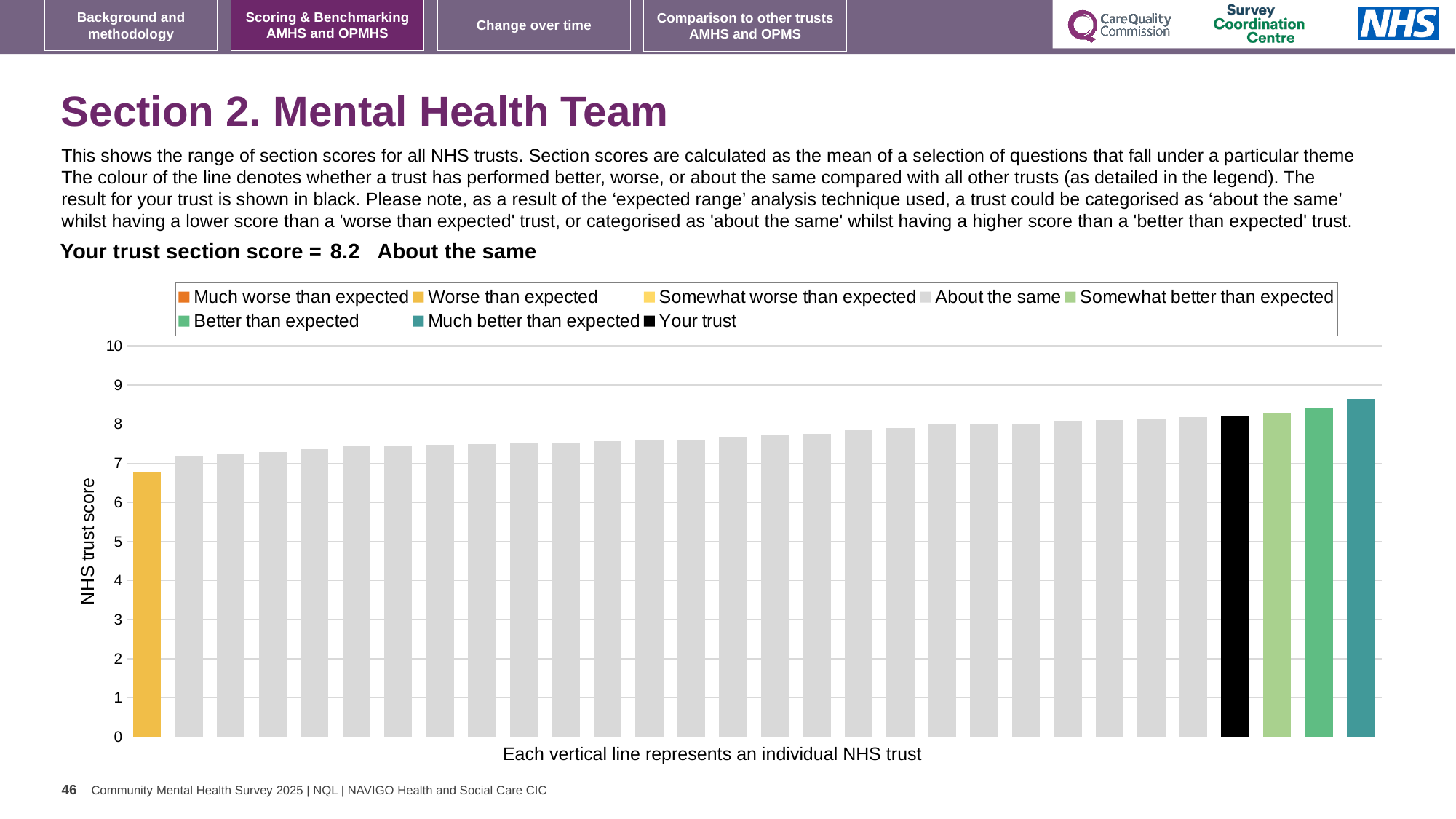
Which legend category does the lowest bar belong to? Worse than expected Do the bar values rise or fall from left to right along the x axis? rise What is the label on the vertical axis of the chart? NHS trust score How many entries does the chart legend list? 8 Which is larger: the value for your trust or the value of the leftmost bar? your trust What kind of chart is shown on the slide? bar chart Which legend category does the highest bar belong to? Much better than expected Is the value for your trust greater or less than 8? greater Which category is your trust's section score placed in? About the same What is the section score for your trust? 8.2 Is the value of the highest bar greater or less than 8? greater Is the value of the lowest bar (the 'Worse than expected' trust) greater or less than 7? less